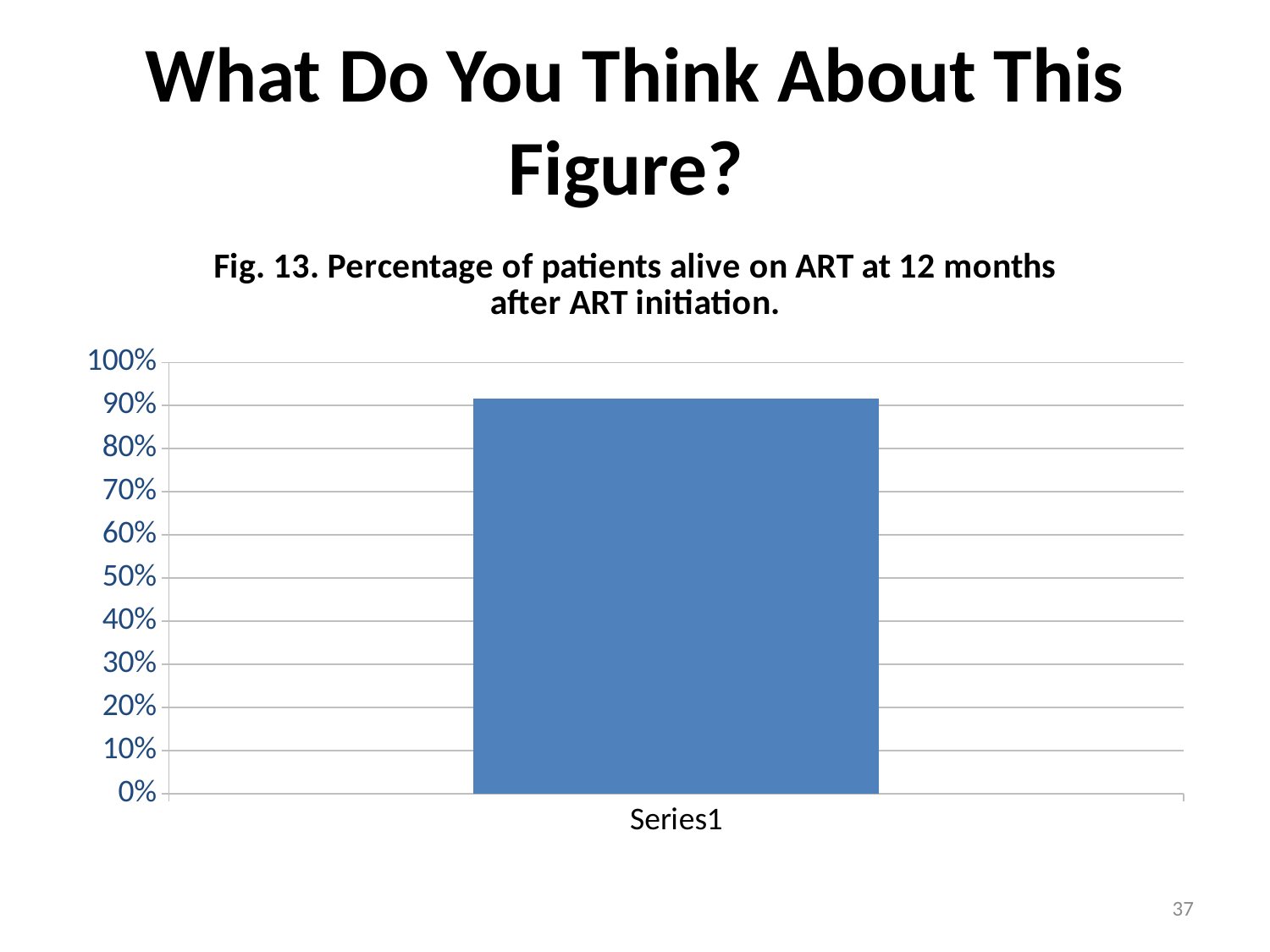
Is the value for Series1 greater or less than 90%? greater How many bars are plotted in the chart? 1 What is the category label shown on the x axis? Series1 What kind of chart is shown on the slide? bar chart Is the value for Series1 greater or less than 100%? less What is the title of the chart? Fig. 13. Percentage of patients alive on ART at 12 months after ART initiation. Is the value for Series1 greater or less than 50%? greater What is the highest value shown on the y axis? 100%